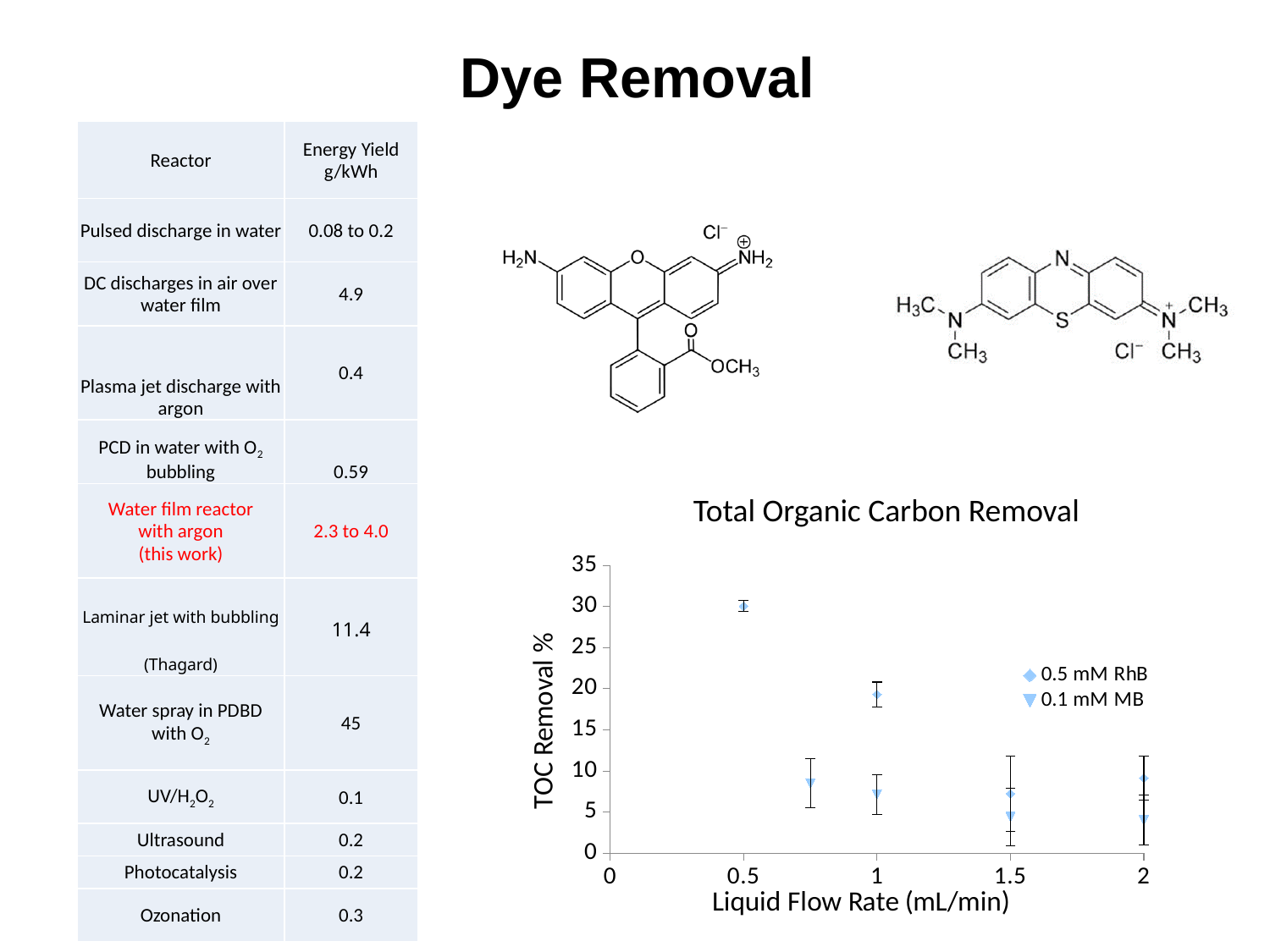
In the Total Organic Carbon Removal chart, at 1 mL/min, which series has the higher TOC removal? 0.5 mM RhB In the Total Organic Carbon Removal chart, is the TOC removal for 0.5 mM RhB at 1 mL/min greater or less than 15? greater What kind of chart is the Total Organic Carbon Removal chart? scatter chart In the Total Organic Carbon Removal chart, is the TOC removal for 0.1 mM MB at 1.5 mL/min greater or less than 10? less In the Total Organic Carbon Removal chart, is the TOC removal for 0.1 mM MB at 2 mL/min greater or less than 10? less What is the label of the x axis of the Total Organic Carbon Removal chart? Liquid Flow Rate (mL/min) How many series does the legend of the Total Organic Carbon Removal chart list? 2 What are the two series named in the legend of the Total Organic Carbon Removal chart? 0.5 mM RhB and 0.1 mM MB How many data points are plotted for the 0.5 mM RhB series in the Total Organic Carbon Removal chart? 4 In the Total Organic Carbon Removal chart, do the 0.5 mM RhB values generally rise or fall as liquid flow rate increases? fall In the Total Organic Carbon Removal chart, at which liquid flow rate is the TOC removal for 0.5 mM RhB highest? 0.5 mL/min